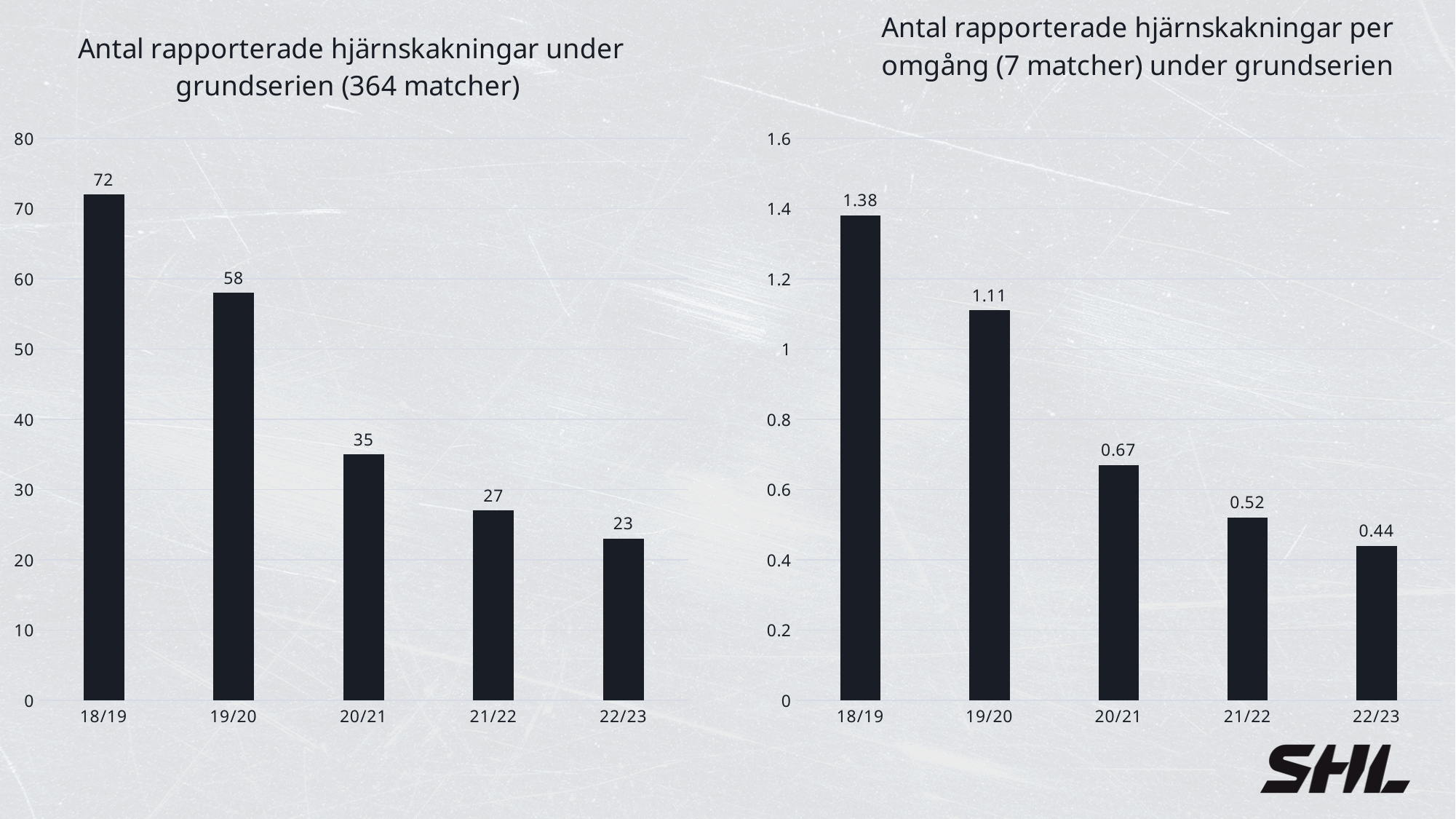
In the left chart (Antal rapporterade hjärnskakningar under grundserien), do the values rise or fall from 18/19 to 22/23? Fall In the left chart (Antal rapporterade hjärnskakningar under grundserien), which is larger, the value for 20/21 or the value for 21/22? 20/21 In the left chart (Antal rapporterade hjärnskakningar under grundserien), which season has the lowest value? 22/23 What kind of chart is the right chart (Antal rapporterade hjärnskakningar per omgång)? Bar chart In the right chart (Antal rapporterade hjärnskakningar per omgång), which season has the highest value? 18/19 How many seasons are shown on the x axis of the left chart (Antal rapporterade hjärnskakningar under grundserien)? 5 In the right chart (Antal rapporterade hjärnskakningar per omgång), what is the value for 20/21? 0.67 What is the title of the right chart? Antal rapporterade hjärnskakningar per omgång (7 matcher) under grundserien In the right chart (Antal rapporterade hjärnskakningar per omgång), is the value for 19/20 greater or less than 1? greater In the left chart (Antal rapporterade hjärnskakningar under grundserien), what is the difference between the values for 18/19 and 19/20? 14 In the right chart (Antal rapporterade hjärnskakningar per omgång), what is the difference between the values for 21/22 and 22/23? 0.08 In the left chart (Antal rapporterade hjärnskakningar under grundserien), what is the value for 18/19? 72